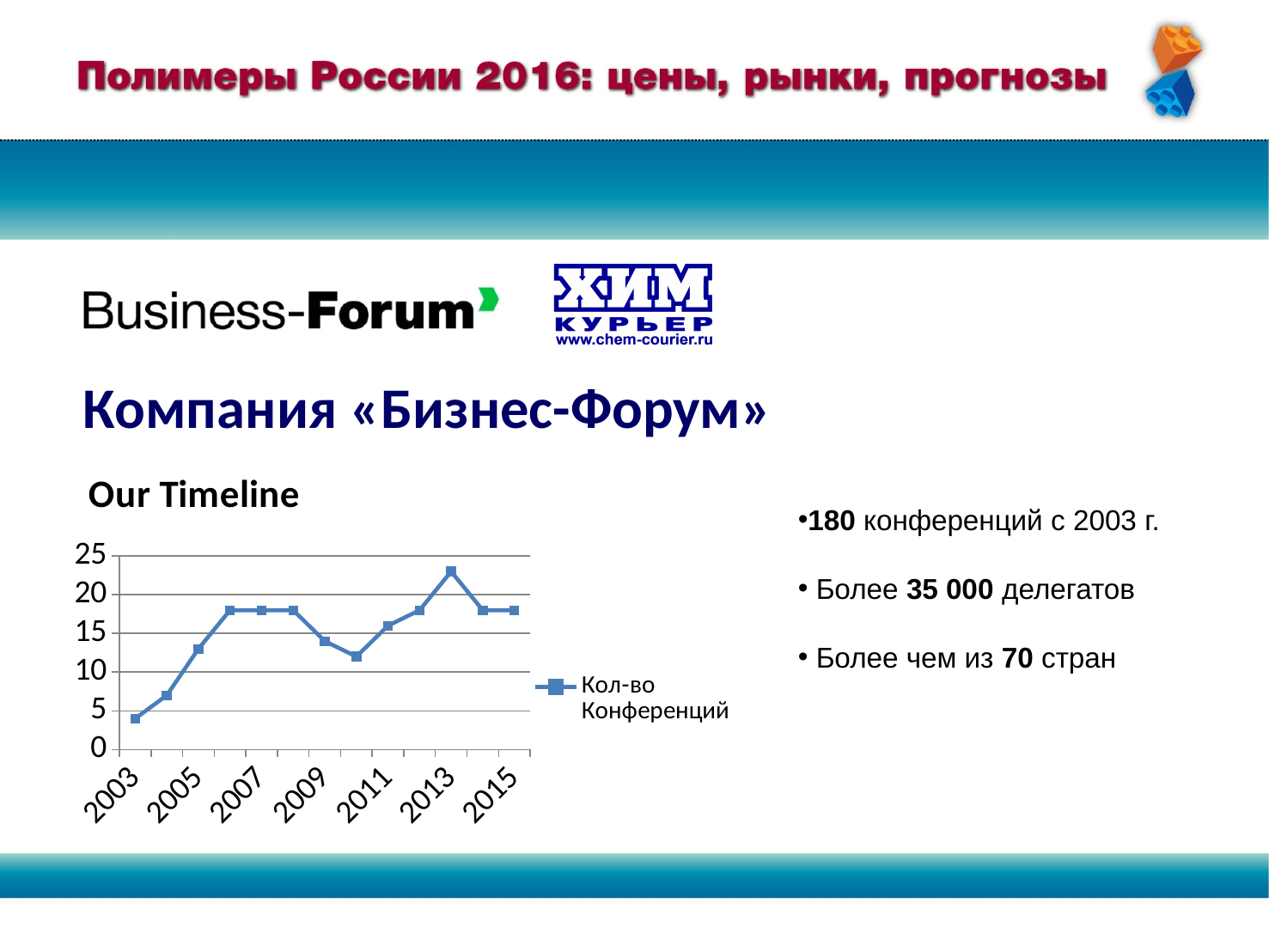
Is the value for 2013 on the "Our Timeline" chart greater or less than 20? greater In which year does the "Our Timeline" chart reach its highest value? 2013 Does the value on the "Our Timeline" chart rise or fall from 2003 to 2007? rise How many series does the legend of the "Our Timeline" chart list? 1 How many data points are plotted on the "Our Timeline" chart? 13 In which year does the "Our Timeline" chart show its lowest value? 2003 What kind of chart is shown under "Our Timeline"? line chart Is the value for 2009 on the "Our Timeline" chart greater or less than 15? less Is the value for 2005 on the "Our Timeline" chart greater or less than 10? greater What is the name of the series shown in the legend of the "Our Timeline" chart? Кол-во Конференций On the "Our Timeline" chart, which year has the larger value, 2013 or 2015? 2013